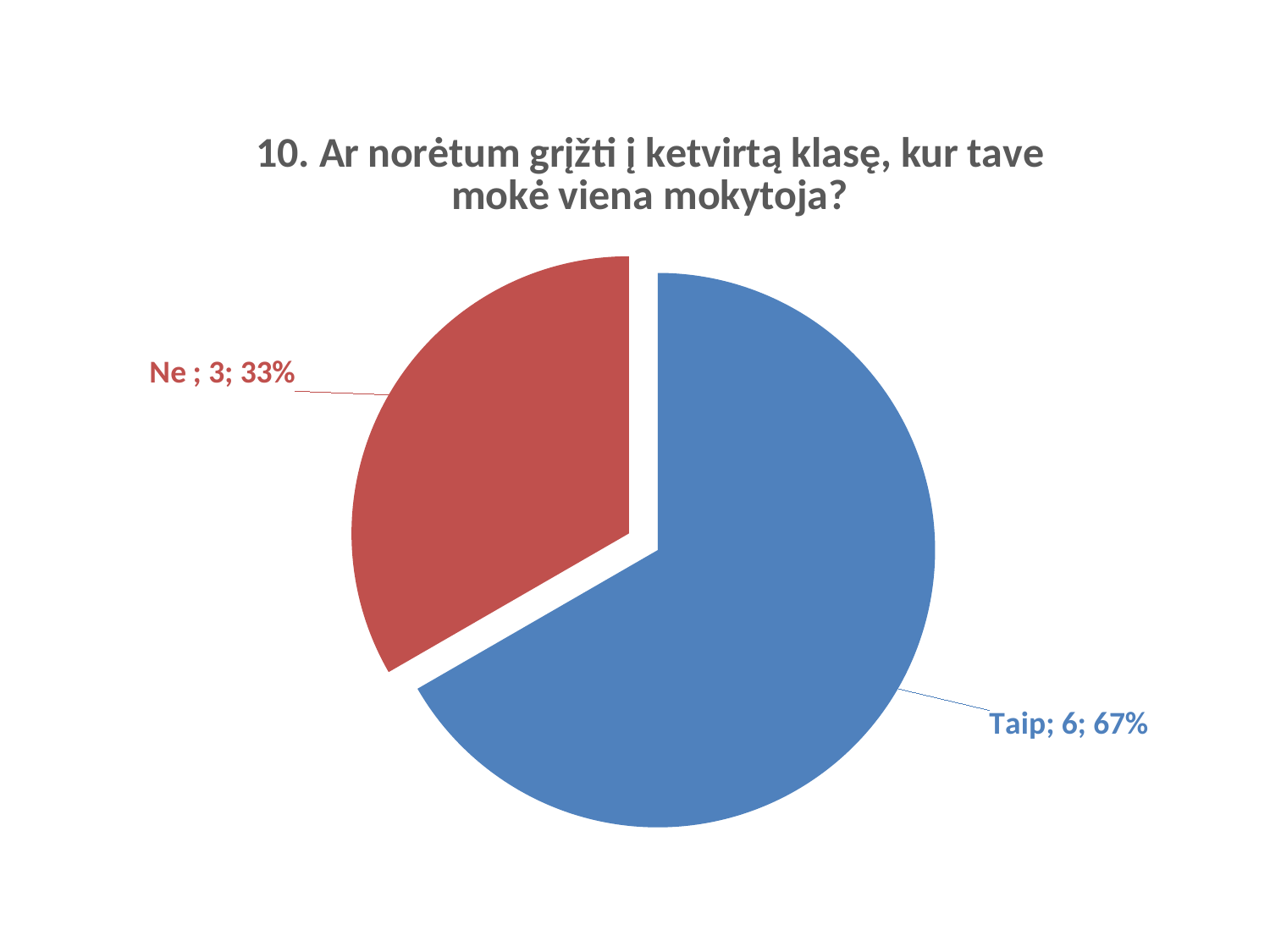
How many slices does the pie chart have? 2 What share of the pie does "Ne" represent? 33% What colour is the "Ne" slice? red What is the count for "Taip"? 6 What share of the pie does "Taip" represent? 67% Which category has the largest slice? Taip What is the count for "Ne"? 3 What is the difference between the counts for "Taip" and "Ne"? 3 What kind of chart is shown on the slide? pie chart Which is larger, the value for "Taip" or the value for "Ne"? Taip What is the total of the counts for "Taip" and "Ne"? 9 Which category has the smallest slice? Ne